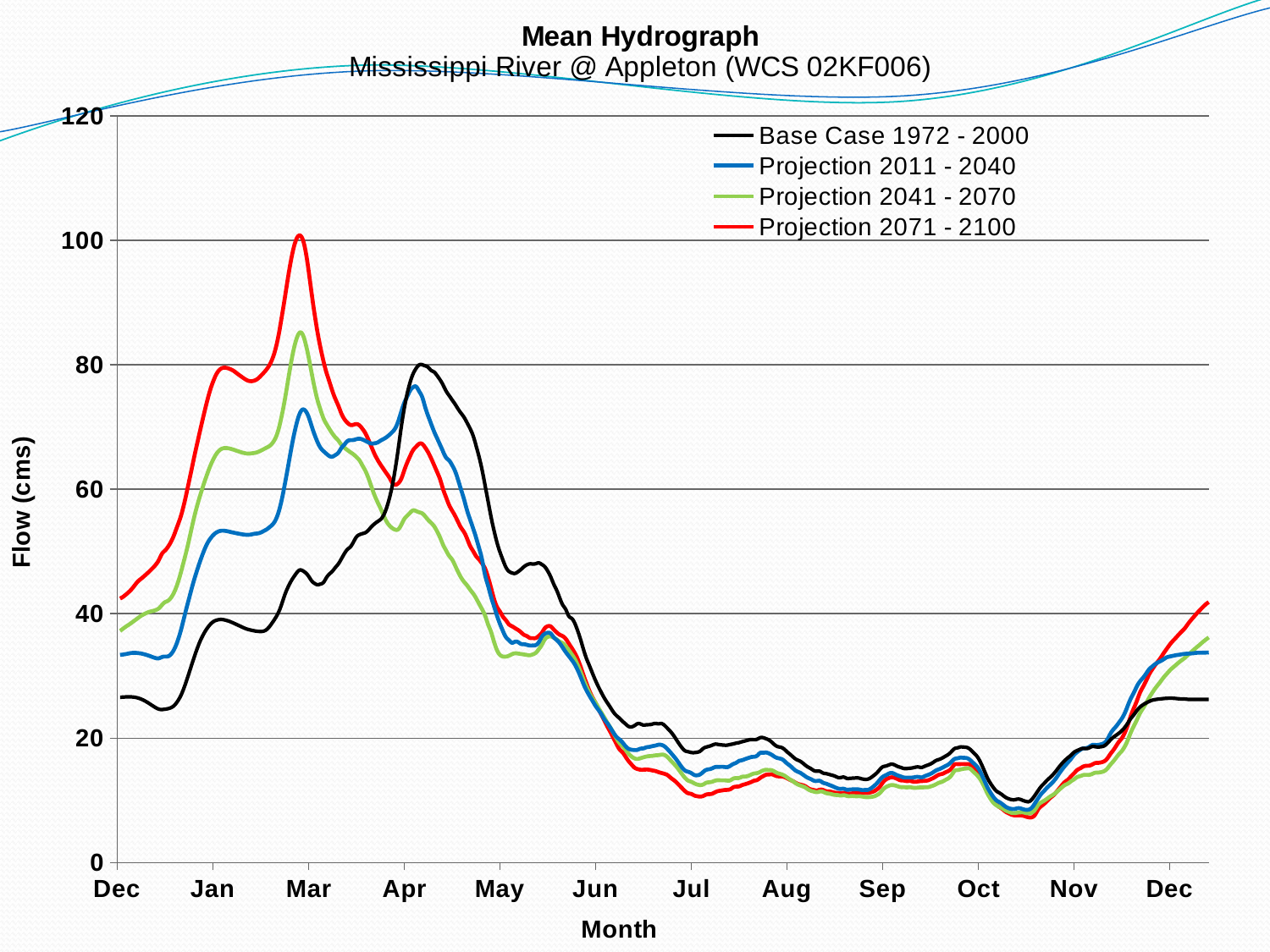
Is the peak value of the Base Case 1972 - 2000 series greater or less than 100? less What is the label of the vertical axis? Flow (cms) Is the Base Case 1972 - 2000 value at the start of Dec greater or less than 40? less How many series does the legend list? 4 What kind of chart is shown on the slide? line chart Does the Base Case 1972 - 2000 flow rise or fall from Apr to Jul? fall Around Mar, which series is higher: Projection 2071 - 2100 or Base Case 1972 - 2000? Projection 2071 - 2100 Does the Projection 2071 - 2100 flow rise or fall from Oct to the Dec at the right end of the axis? rise Which series reaches the highest peak flow on the chart? Projection 2071 - 2100 Is the peak value of the Projection 2071 - 2100 series greater or less than 80? greater What is the main title of the chart? Mean Hydrograph Which series has the lowest flow at the start of Dec on the left of the chart? Base Case 1972 - 2000